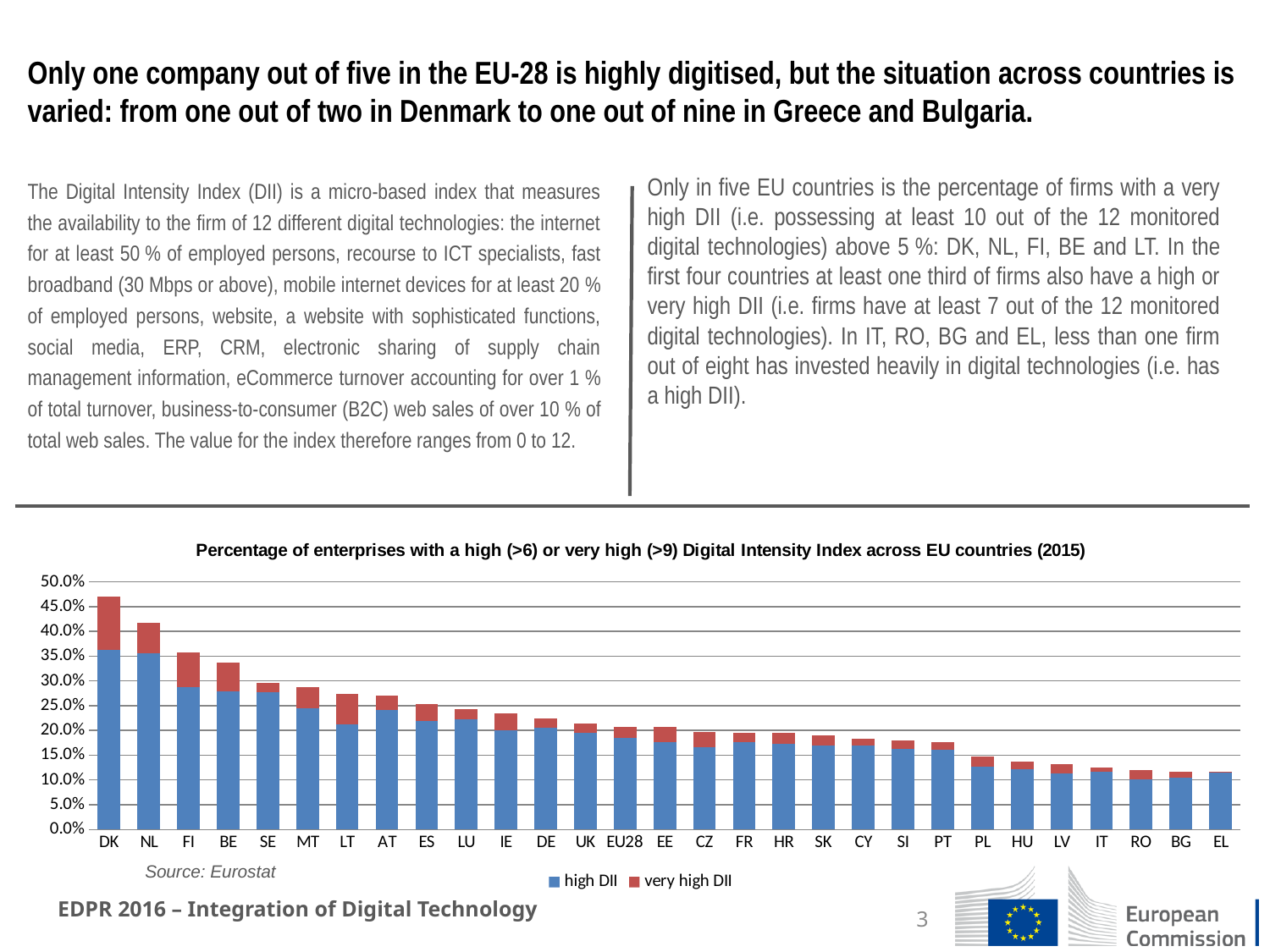
How many countries/categories are shown along the x axis? 29 Which has a larger total value, DK or NL? DK Is the total value for DK greater or less than 45.0%? greater What kind of chart is shown on the slide? Stacked bar chart Is the total value for EL greater or less than 15.0%? less Which colour represents the 'very high DII' series? Red How many series does the legend list? 2 Is the total value for EU28 greater or less than 25.0%? less Do the total bar values rise or fall moving from left to right along the x axis? Fall What are the two series named in the legend? high DII and very high DII Which country has the highest total percentage of enterprises with a high or very high DII? DK